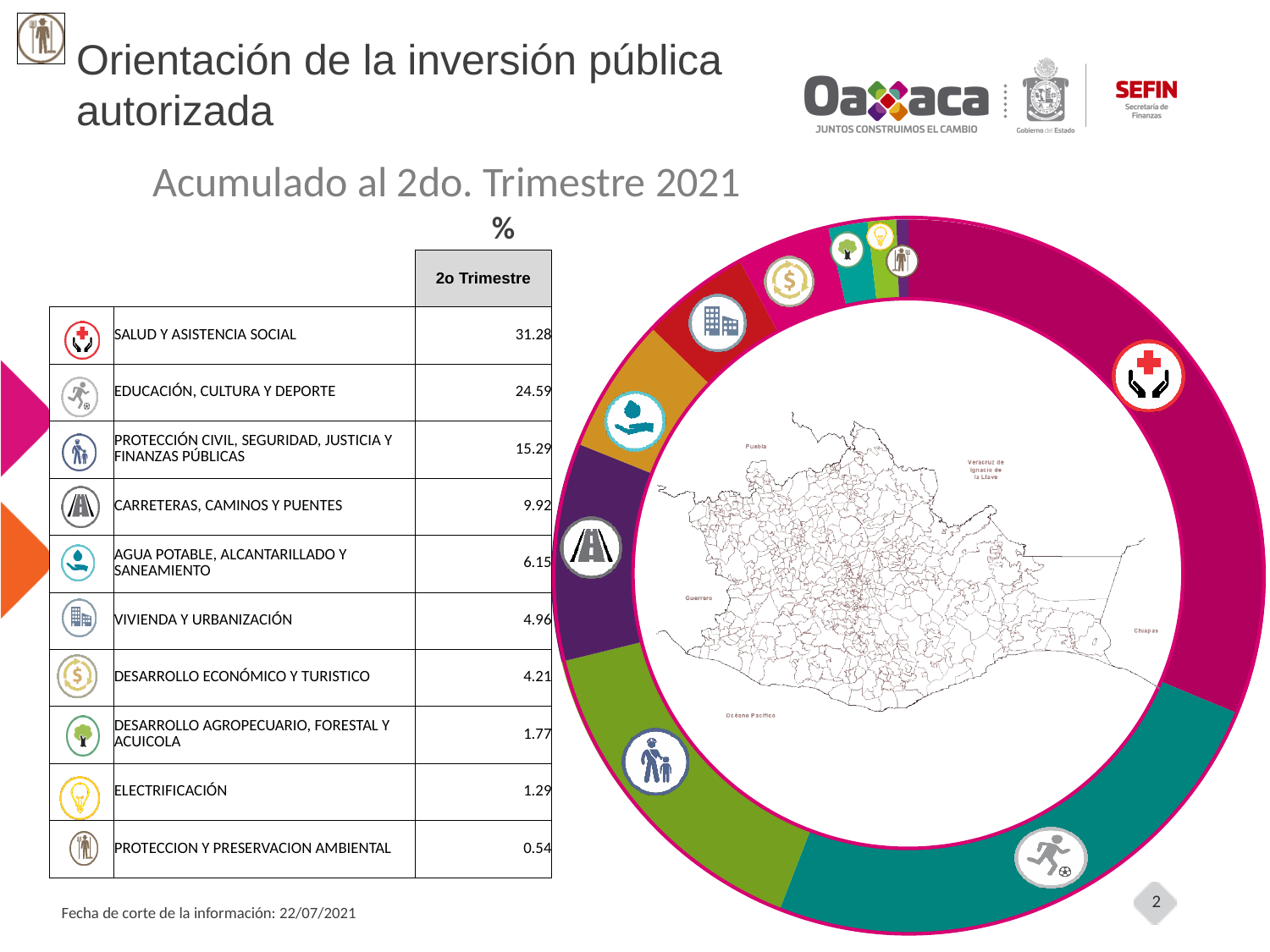
How many categories are listed in the table accompanying the doughnut chart? 10 What period does the subtitle above the chart say the data is accumulated to? Acumulado al 2do. Trimestre 2021 What is the difference between the percentages for SALUD Y ASISTENCIA SOCIAL and EDUCACIÓN, CULTURA Y DEPORTE? 6.69 Which category has the lowest percentage? PROTECCION Y PRESERVACION AMBIENTAL What kind of chart is shown on the slide? doughnut chart What is the title of the slide containing the doughnut chart? Orientación de la inversión pública autorizada Which category has the highest percentage? SALUD Y ASISTENCIA SOCIAL What is the percentage for ELECTRIFICACIÓN? 1.29 What is the percentage for CARRETERAS, CAMINOS Y PUENTES? 9.92 What is the percentage for SALUD Y ASISTENCIA SOCIAL in the 2o Trimestre column? 31.28 Which has a larger percentage, VIVIENDA Y URBANIZACIÓN or DESARROLLO ECONÓMICO Y TURISTICO? VIVIENDA Y URBANIZACIÓN What is the difference between the percentages for CARRETERAS, CAMINOS Y PUENTES and AGUA POTABLE, ALCANTARILLADO Y SANEAMIENTO? 3.77